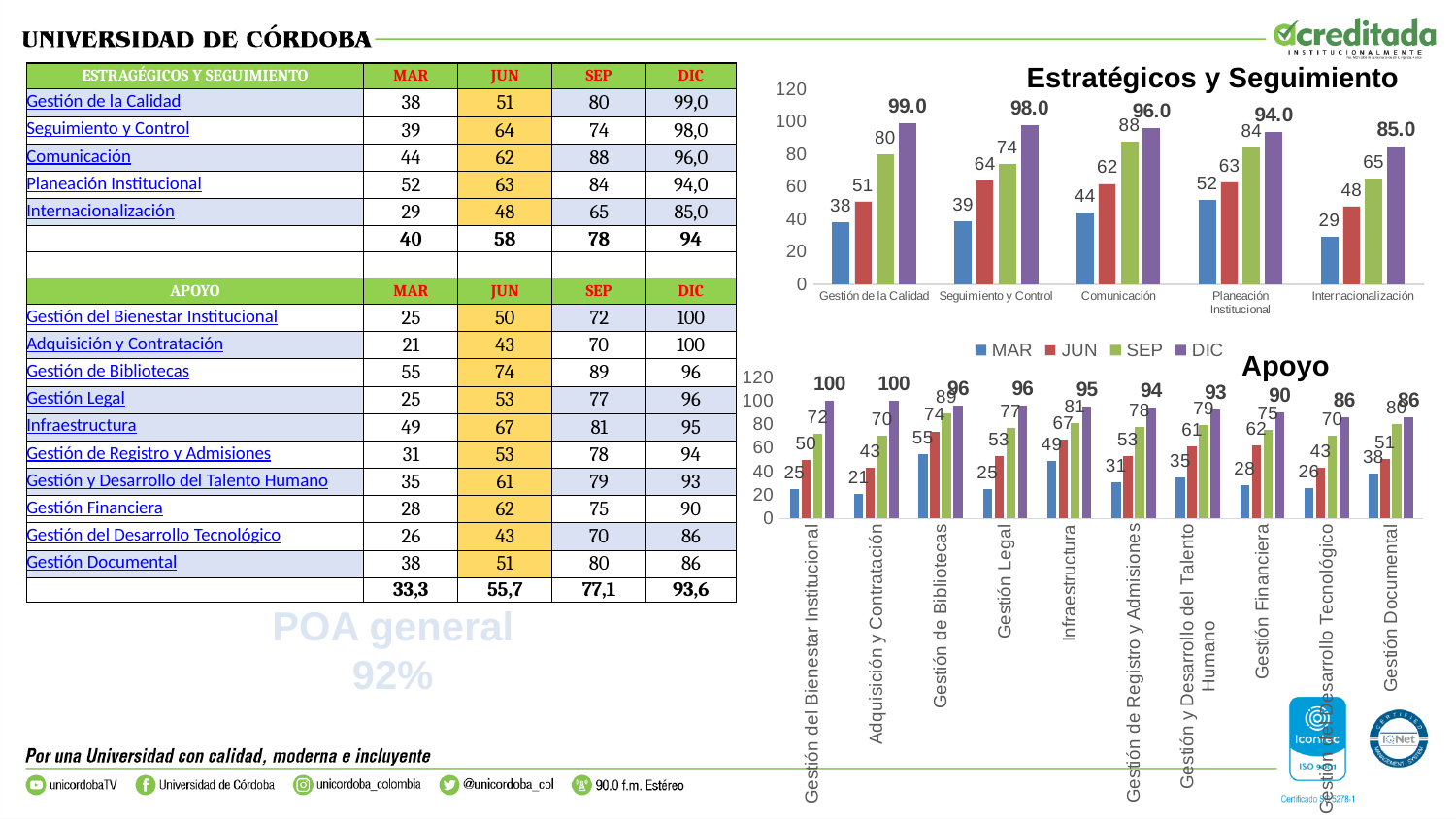
In the 'Apoyo' chart, is the JUN value for Infraestructura larger than the JUN value for Gestión Financiera? Yes In the 'Estratégicos y Seguimiento' chart, how many categories are shown on the x axis? 5 In the 'Apoyo' chart, which category has the lowest DIC value? Gestión del Desarrollo Tecnológico and Gestión Documental (86) In the 'Estratégicos y Seguimiento' chart, what is the DIC value for Gestión de la Calidad? 99.0 How many series does the legend list for the charts? 4 In the 'Estratégicos y Seguimiento' chart, do the values for Planeación Institucional rise or fall from MAR to DIC? Rise In the 'Apoyo' chart, what is the MAR value for Gestión de Bibliotecas? 55 In the 'Estratégicos y Seguimiento' chart, what is the difference between the SEP and JUN values for Seguimiento y Control? 10 In the 'Apoyo' chart, how many categories are shown on the x axis? 10 In the 'Estratégicos y Seguimiento' chart, which category has the lowest MAR value? Internacionalización What type of chart is the 'Apoyo' chart? Bar chart In the 'Estratégicos y Seguimiento' chart, what is the SEP value for Comunicación? 88